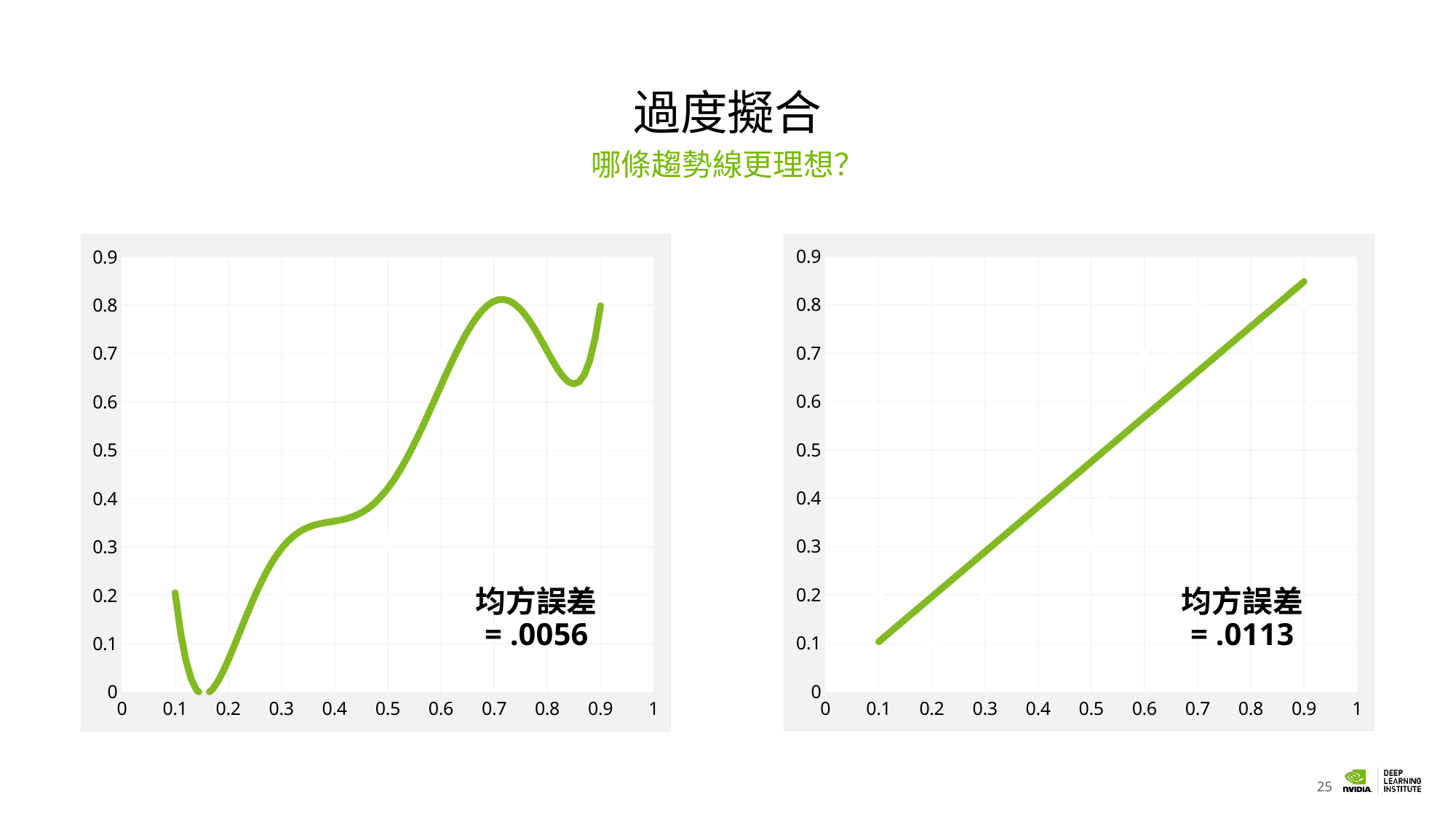
Which chart has the lower 均方誤差 (mean squared error), the left or the right? the left What kind of chart is the chart on the left? line chart In the chart on the right, is the value at x = 0.9 greater or less than 0.8? greater In the chart on the left, is the value at x = 0.2 greater or less than 0.2? less In the chart on the left, is the value larger at x = 0.7 or at x = 0.85? x = 0.7 In the chart on the right, do the values rise or fall as x increases from 0.1 to 0.9? rise In the chart on the right, is the value at x = 0.1 greater or less than 0.2? less What 均方誤差 value is printed on the chart on the left? .0056 What kind of chart is the chart on the right? line chart What 均方誤差 value is printed on the chart on the right? .0113